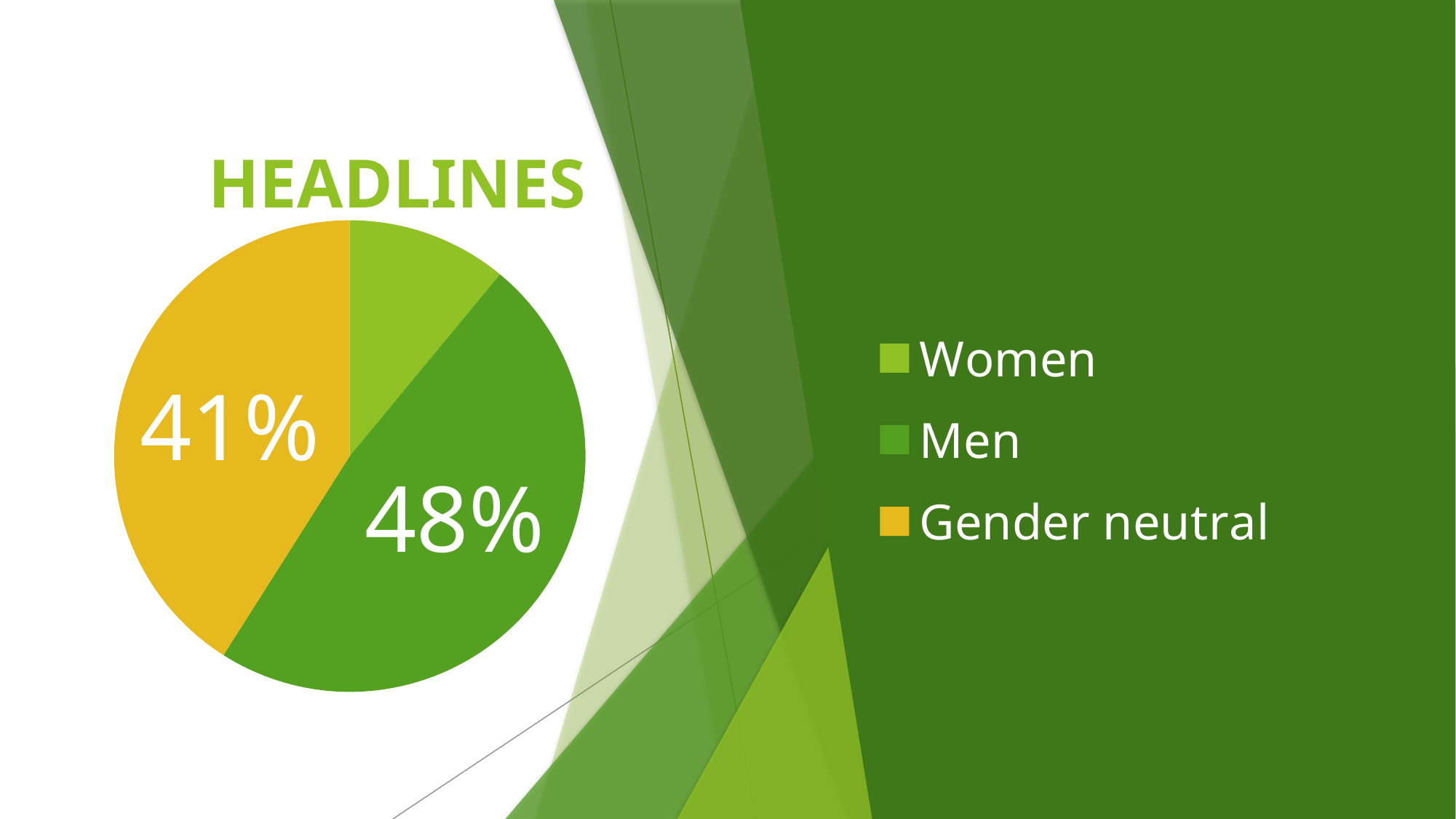
What kind of chart is shown on the slide? pie chart Which colour represents Gender neutral in the legend? yellow Which slice is larger, Men or Gender neutral? Men What percentage of the pie is labelled for Gender neutral? 41% Which slice is larger, Women or Gender neutral? Gender neutral What is the title of the chart? HEADLINES By how many percentage points does the Men slice exceed the Gender neutral slice? 7 percentage points What percentage of the pie is labelled for Men? 48% Which category has the largest slice of the pie? Men Which category has the smallest slice of the pie? Women How many categories does the legend list? 3 What share of the pie does the Men slice represent? 48%